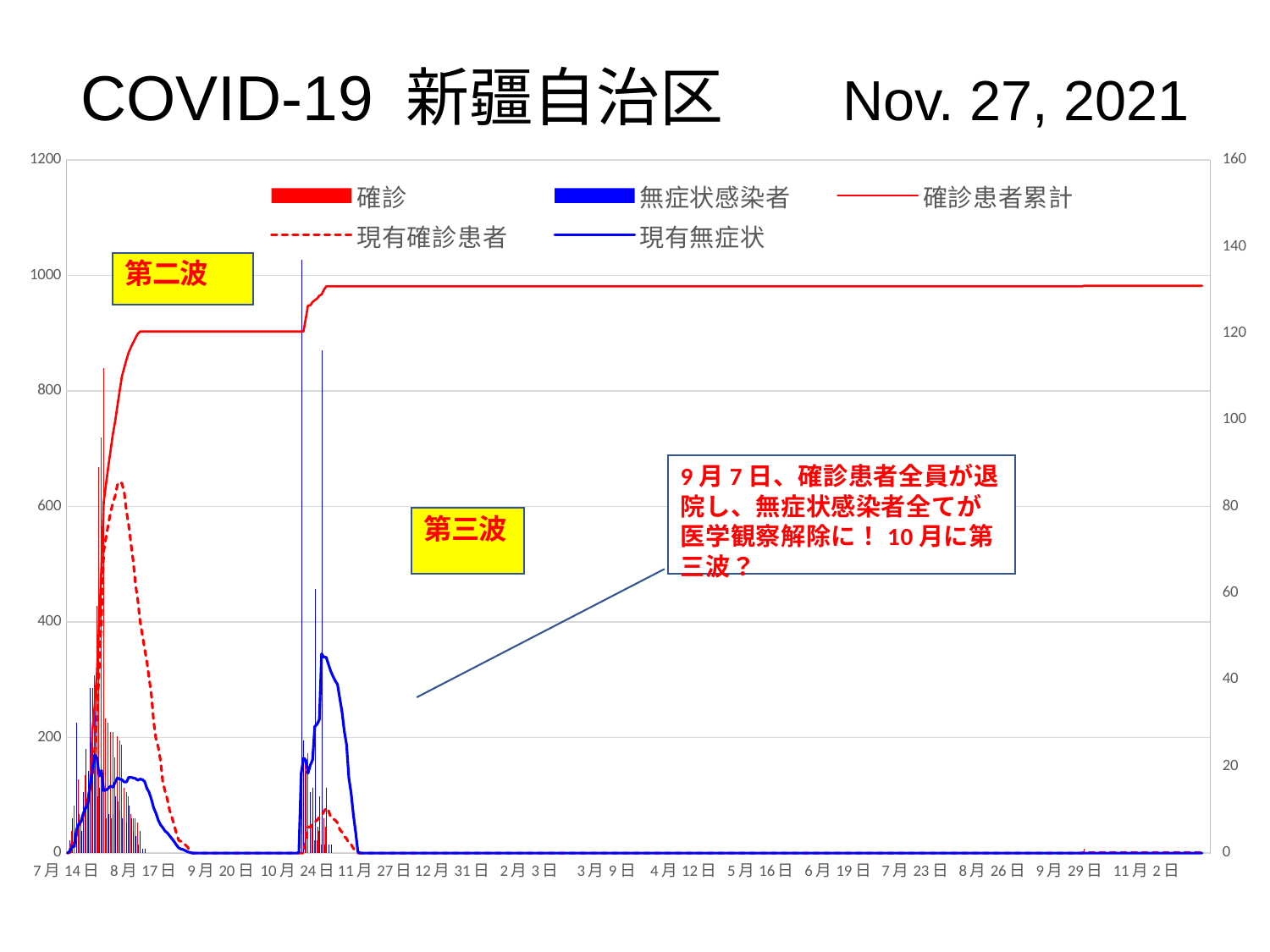
What are the two wave labels shown in yellow boxes on the chart? 第二波 and 第三波 Which wave has the higher peak of the 現有無症状 blue line, 第二波 or 第三波? 第三波 What is the maximum value shown on the left vertical axis? 1200 Which wave has the higher peak of the 現有確診患者 dashed line, 第二波 or 第三波? 第二波 Is the final value of the 確診患者累計 line (left axis) greater or less than 800? greater Does the 確診患者累計 line rise or fall along the x axis overall? Rises Is the peak of the 現有確診患者 dashed line during 第二波 (left axis) greater or less than 400? greater Is the final value of the 確診患者累計 line (left axis) greater or less than 1000? less How many series does the chart legend list? 5 What is the title of the slide containing the chart? COVID-19 新疆自治区 Nov. 27, 2021 What kind of chart is shown on the slide? A combination bar and line chart What is the maximum value shown on the right vertical axis? 160